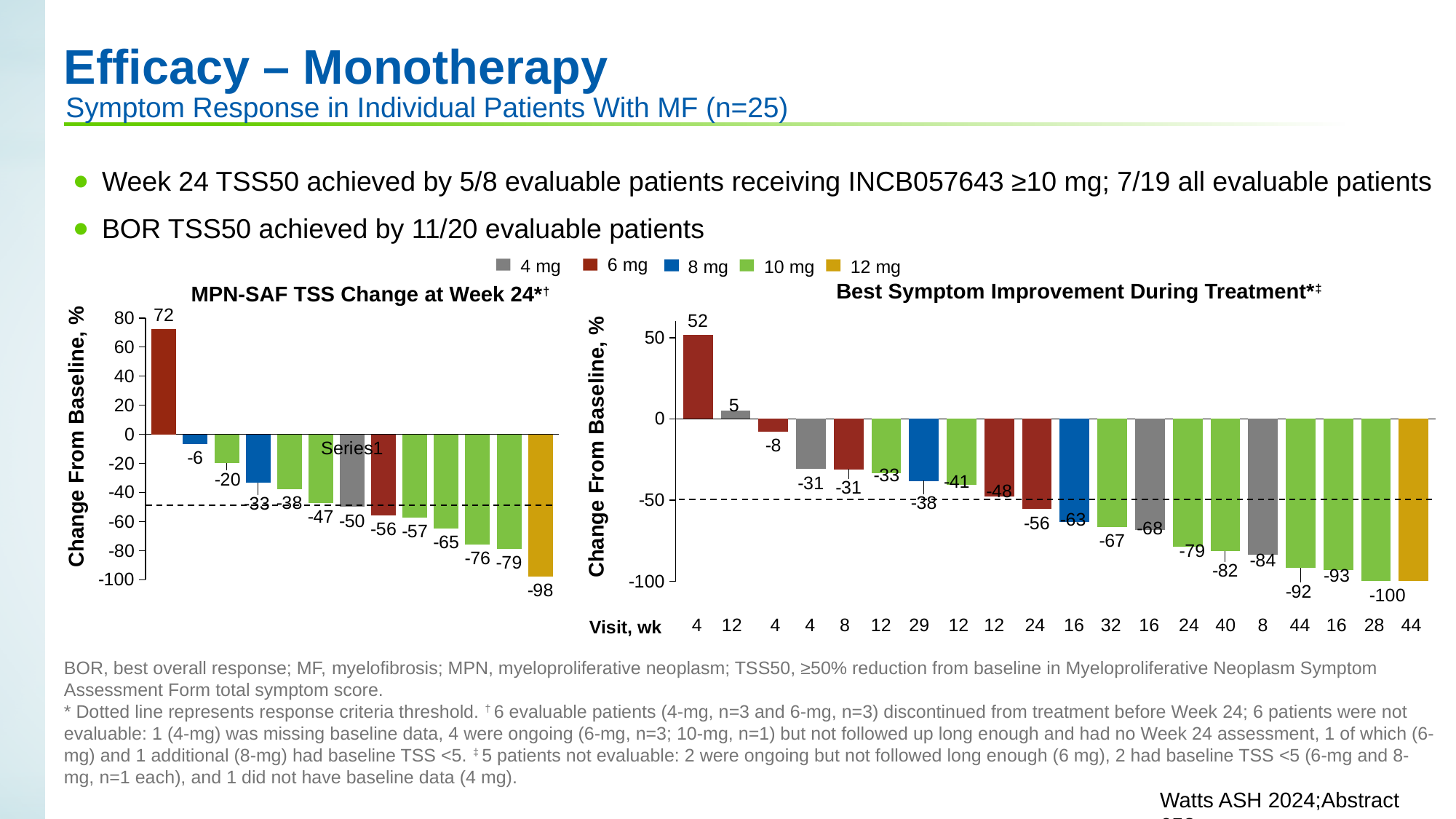
In the 'MPN-SAF TSS Change at Week 24' chart, what is the difference between the highest value (72) and the lowest value (-98)? 170 How many dose groups does the shared legend list? 5 How many bars are plotted in the 'MPN-SAF TSS Change at Week 24' chart? 13 In the 'MPN-SAF TSS Change at Week 24' chart, what is the highest value shown? 72 In the 'Best Symptom Improvement During Treatment' chart, what is the highest value shown? 52 In the 'Best Symptom Improvement During Treatment' chart, what is the value of the second bar? 5 In the 'MPN-SAF TSS Change at Week 24' chart, what is the value of the gray (4 mg) bar? -50 In the 'Best Symptom Improvement During Treatment' chart, how many bars have a positive value? 2 What is the y-axis title of the 'Best Symptom Improvement During Treatment' chart? Change From Baseline, % What kind of chart is the 'MPN-SAF TSS Change at Week 24' chart? Bar chart In the 'Best Symptom Improvement During Treatment' chart, which is larger: the third bar (-8) or the fourth bar (-31)? -8 In the 'MPN-SAF TSS Change at Week 24' chart, what is the lowest value shown? -98